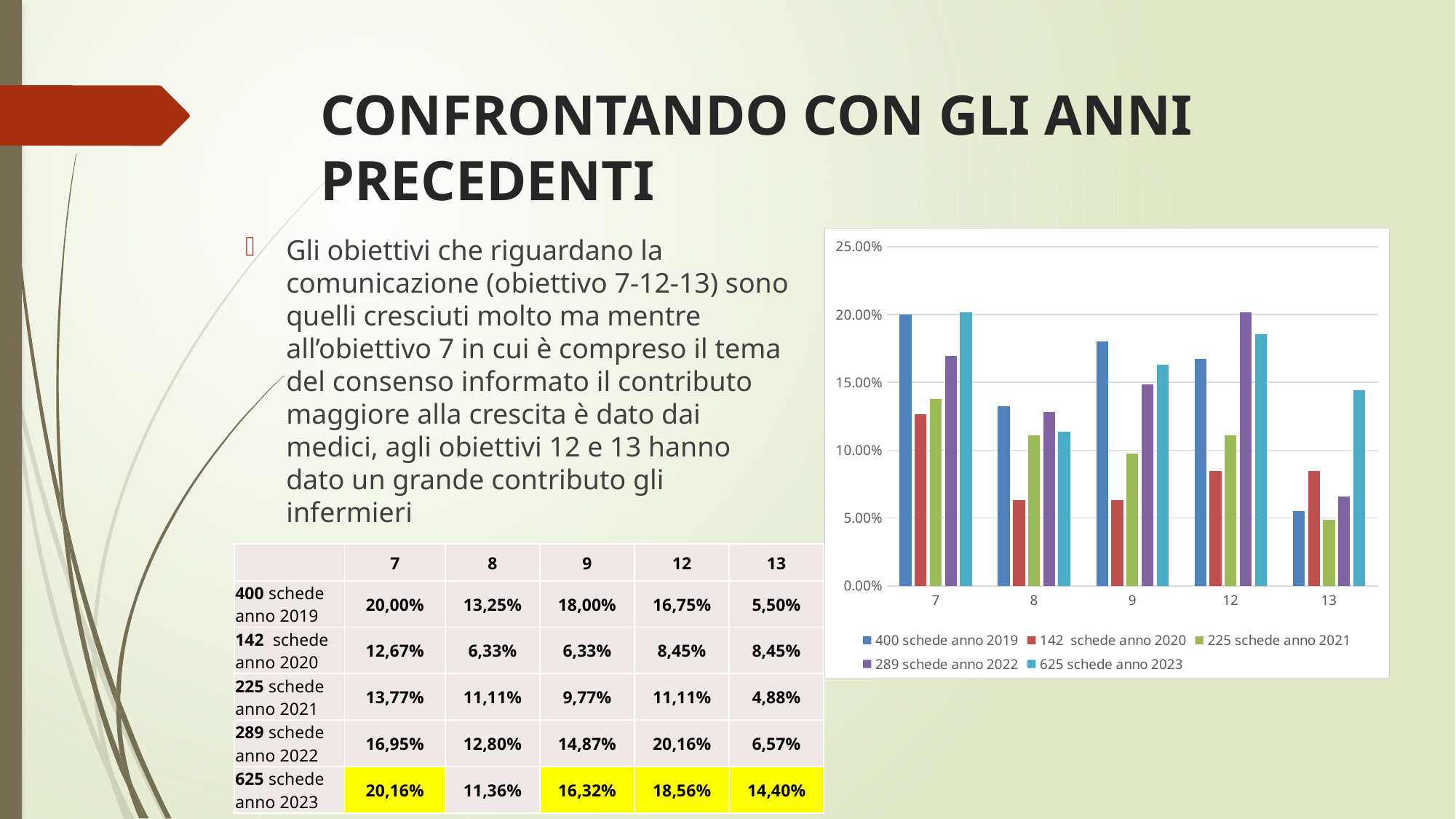
How many series does the chart legend list? 5 Which category has the highest value in the series '400 schede anno 2019'? 7 Which category has the lowest value in the series '225 schede anno 2021'? 13 Which series is shown in light blue in the chart legend? 625 schede anno 2023 What kind of chart is shown on the slide? bar chart What is the value for category 7 in the series '625 schede anno 2023'? 20,16% What is the value for category 12 in the series '289 schede anno 2022'? 20,16% Is the value for category 9 in the series '142 schede anno 2020' greater or less than 10.00%? less For category 8, which series has the larger value: '400 schede anno 2019' or '142 schede anno 2020'? 400 schede anno 2019 How many categories are shown on the x axis of the chart? 5 What is the value for category 13 in the series '400 schede anno 2019'? 5,50% What is the difference between the values for category 13 in the series '625 schede anno 2023' and '400 schede anno 2019'? 8,90%